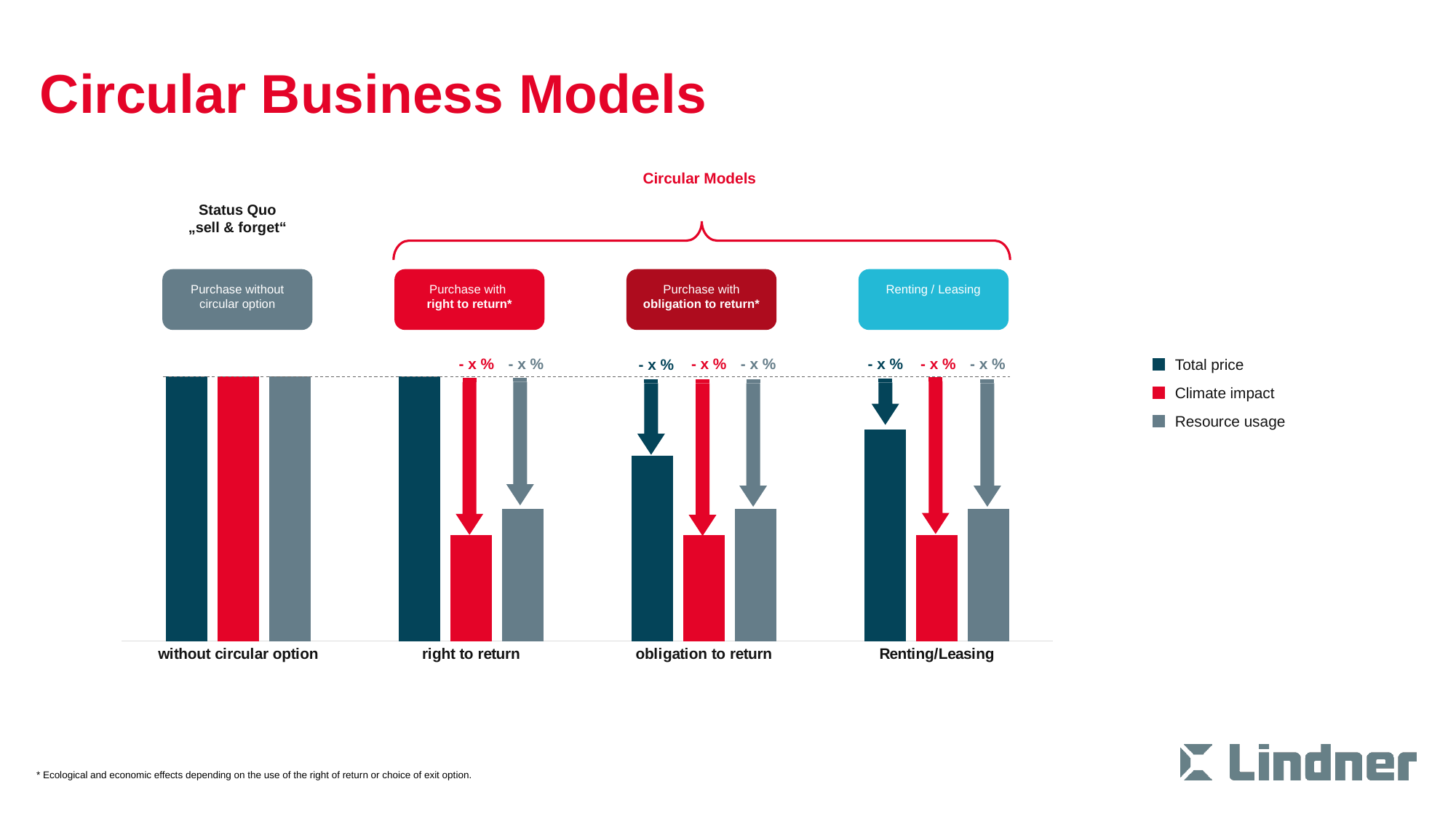
Which category has the lowest Total price bar? obligation to return Which series does the red colour represent in the chart? Climate impact Is the Total price bar larger for Renting/Leasing or for obligation to return? Renting/Leasing Does the Climate impact value rise or fall from without circular option to right to return? fall Is the Total price bar larger for right to return or for Renting/Leasing? right to return Which category has the highest Climate impact bar? without circular option How many series does the chart's legend list? 3 How many categories are shown along the x axis of the chart? 4 Which series does the dark blue colour represent in the chart? Total price Which category has the highest Resource usage bar? without circular option What kind of chart is shown on the slide? bar chart Is the Climate impact bar larger for without circular option or for obligation to return? without circular option